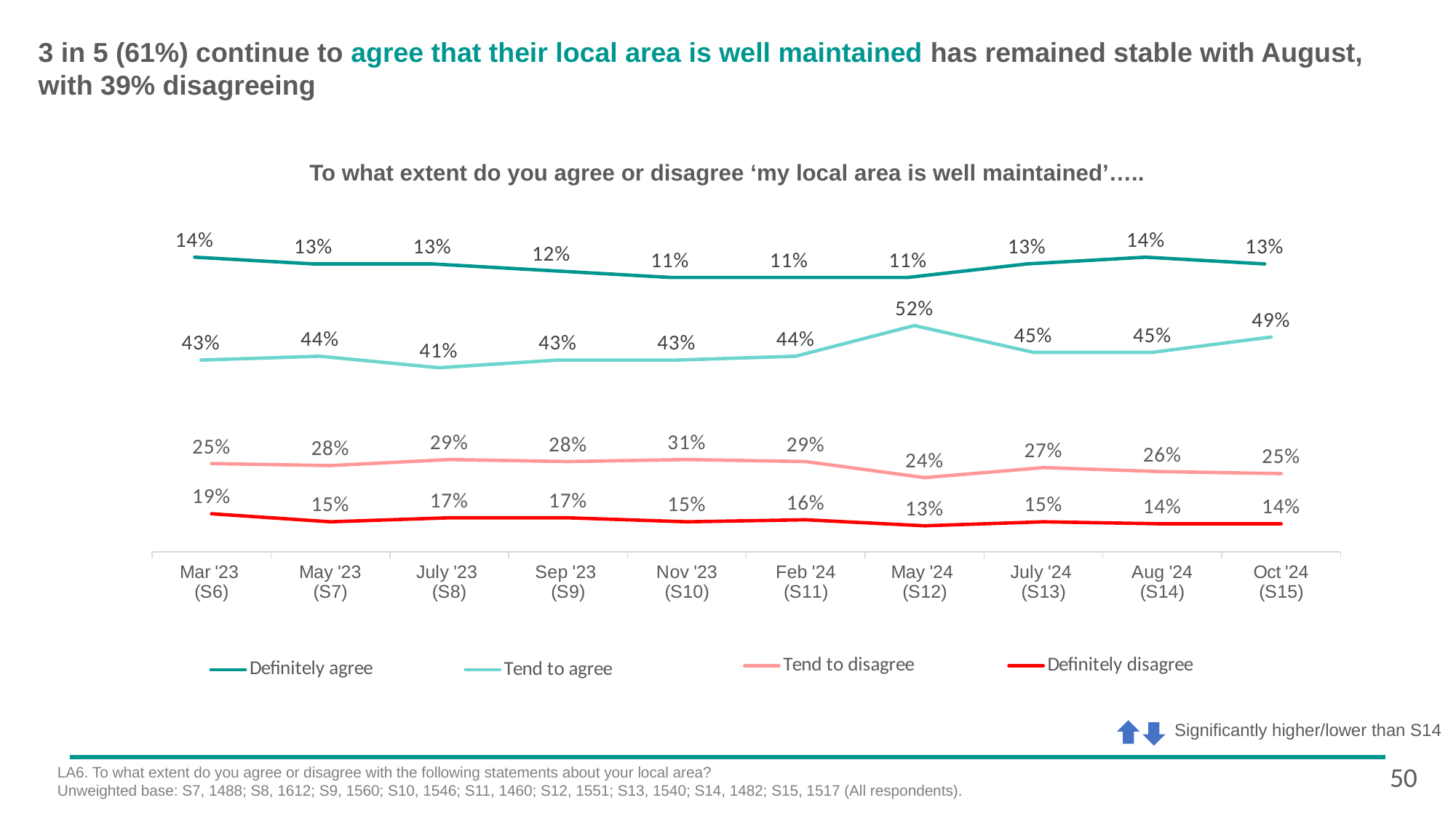
What kind of chart is shown on the slide? line chart In which period is the Tend to agree value highest? May '24 (S12) What is the value for Tend to disagree in Nov '23 (S10)? 31% What is the value for Definitely disagree in Mar '23 (S6)? 19% In which period is the Definitely disagree value lowest? May '24 (S12) How many time points are plotted along the x axis? 10 How many series does the legend list? 4 What is the title of the chart? To what extent do you agree or disagree ‘my local area is well maintained’….. What is the value for Tend to agree in May '24 (S12)? 52% Which is larger in Oct '24 (S15): Tend to disagree or Definitely disagree? Tend to disagree What is the difference between the Tend to agree value in Oct '24 (S15) and in Aug '24 (S14)? 4% Does the Tend to disagree line rise or fall from Mar '23 (S6) to Nov '23 (S10)? rise